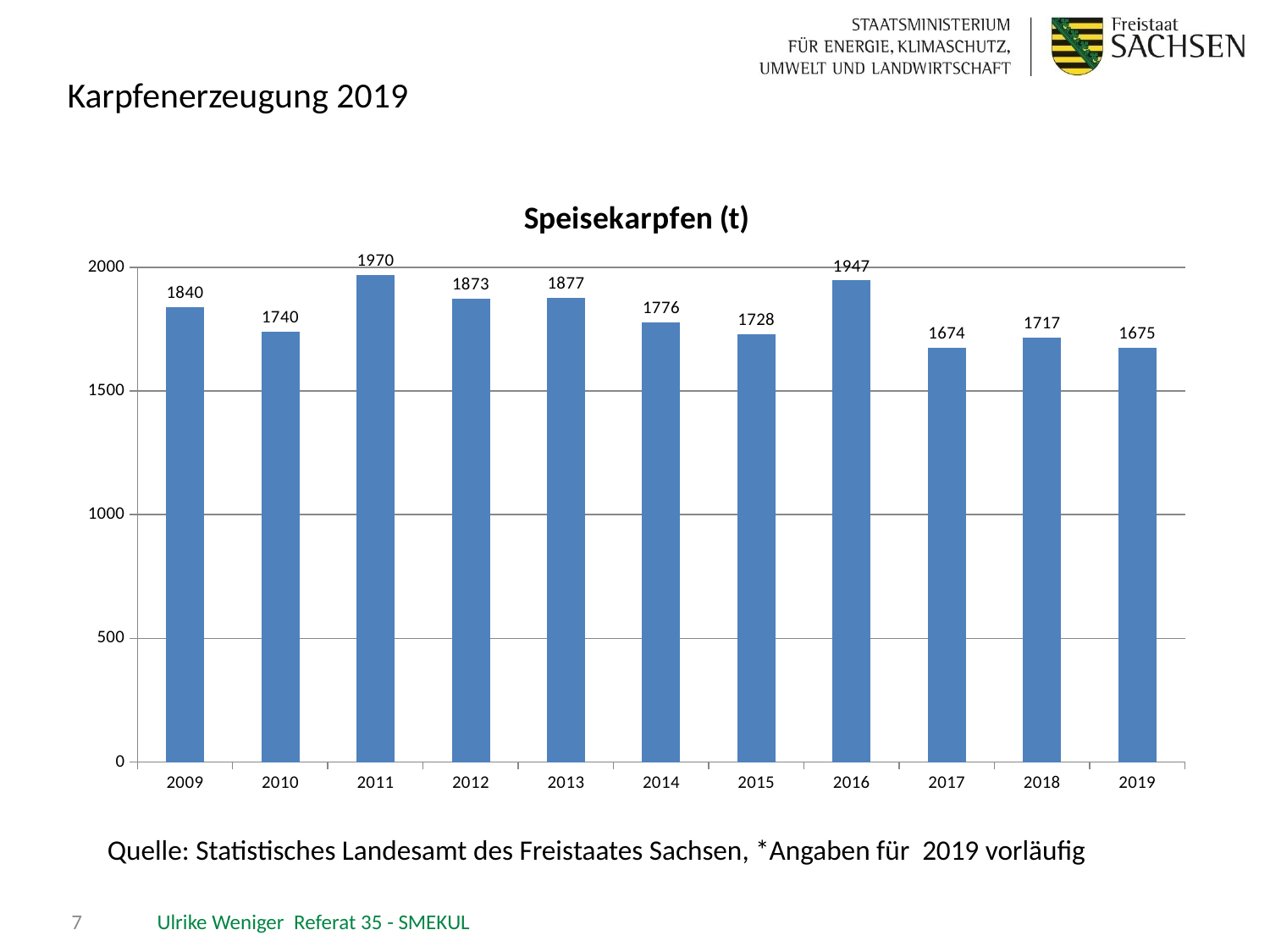
Which is larger, the value for 2009 or the value for 2010? 2009 Which year has the lowest value? 2017 What kind of chart is shown? bar chart What is the value for 2017? 1674 What is the value for 2011? 1970 Is the value for 2014 greater or less than 1500? greater How many years are shown on the x axis? 11 What is the difference between the values for 2016 and 2015? 219 Which year has the highest value? 2011 What is the difference between the values for 2011 and 2017? 296 Do the values rise or fall from 2016 to 2017? fall What is the title of the chart? Speisekarpfen (t)